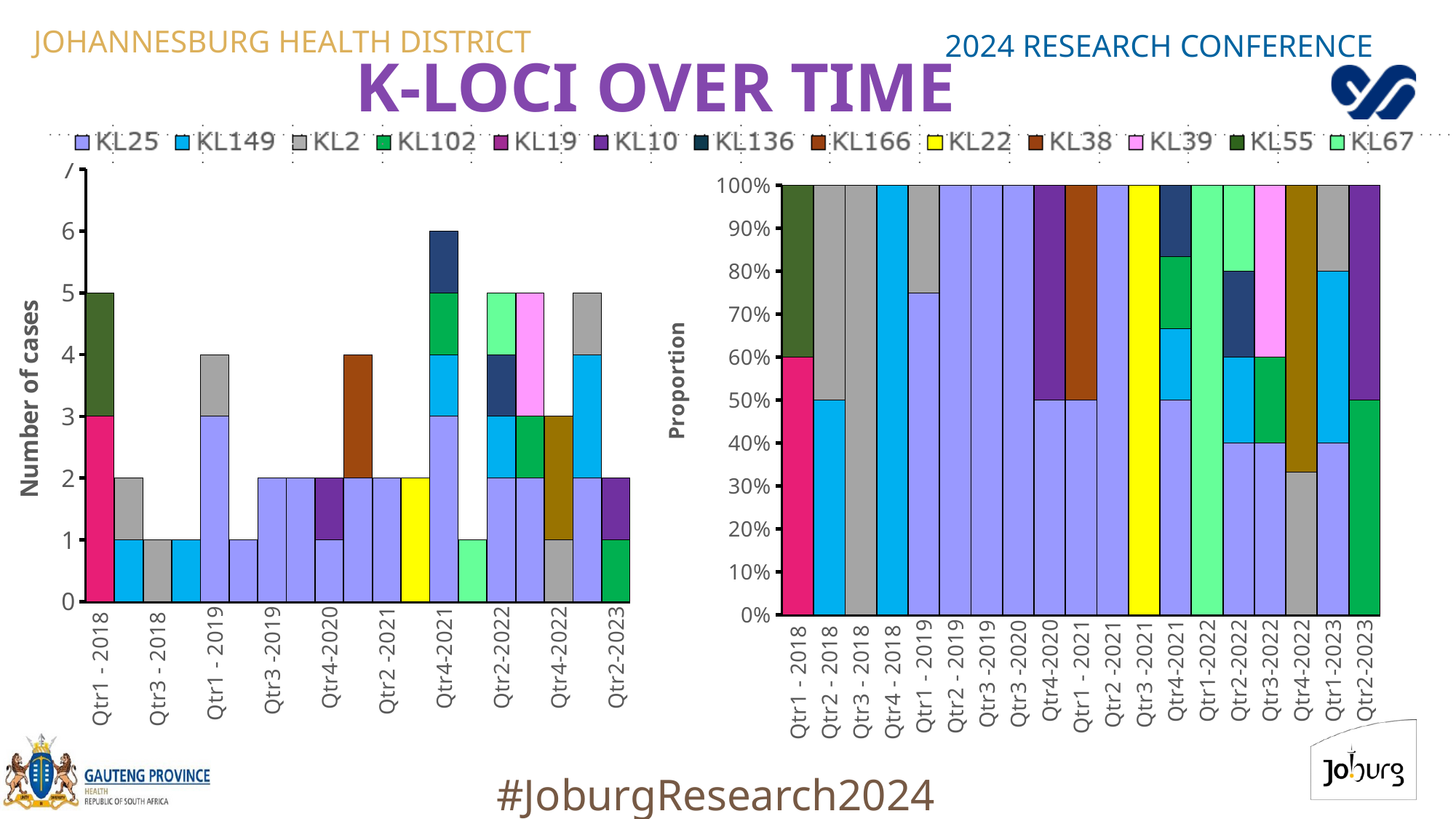
In the right chart (Proportion), what proportion does KL25 make up in Qtr1 - 2019? 75% In the left chart (Number of cases), which quarter has the highest total number of cases? Qtr4-2021 In the right chart (Proportion), how many quarter categories are shown on the x axis? 19 In the left chart (Number of cases), what is the difference between the total cases in Qtr4-2021 and Qtr1 - 2018? 1 In the left chart (Number of cases), which has more total cases: Qtr1 - 2019 or Qtr4-2022? Qtr1 - 2019 How many K-loci series does the legend list? 13 In the right chart (Proportion), what proportion does KL19 make up in Qtr1 - 2018? 60% What kind of chart is the left chart on the slide? Stacked bar chart In the right chart (Proportion), what proportion does KL149 make up in Qtr2 - 2018? 50% In the left chart (Number of cases), what is the total number of cases for Qtr1 - 2018? 5 In the left chart (Number of cases), what is the total number of cases for Qtr4-2021? 6 What is the y-axis title of the left chart? Number of cases